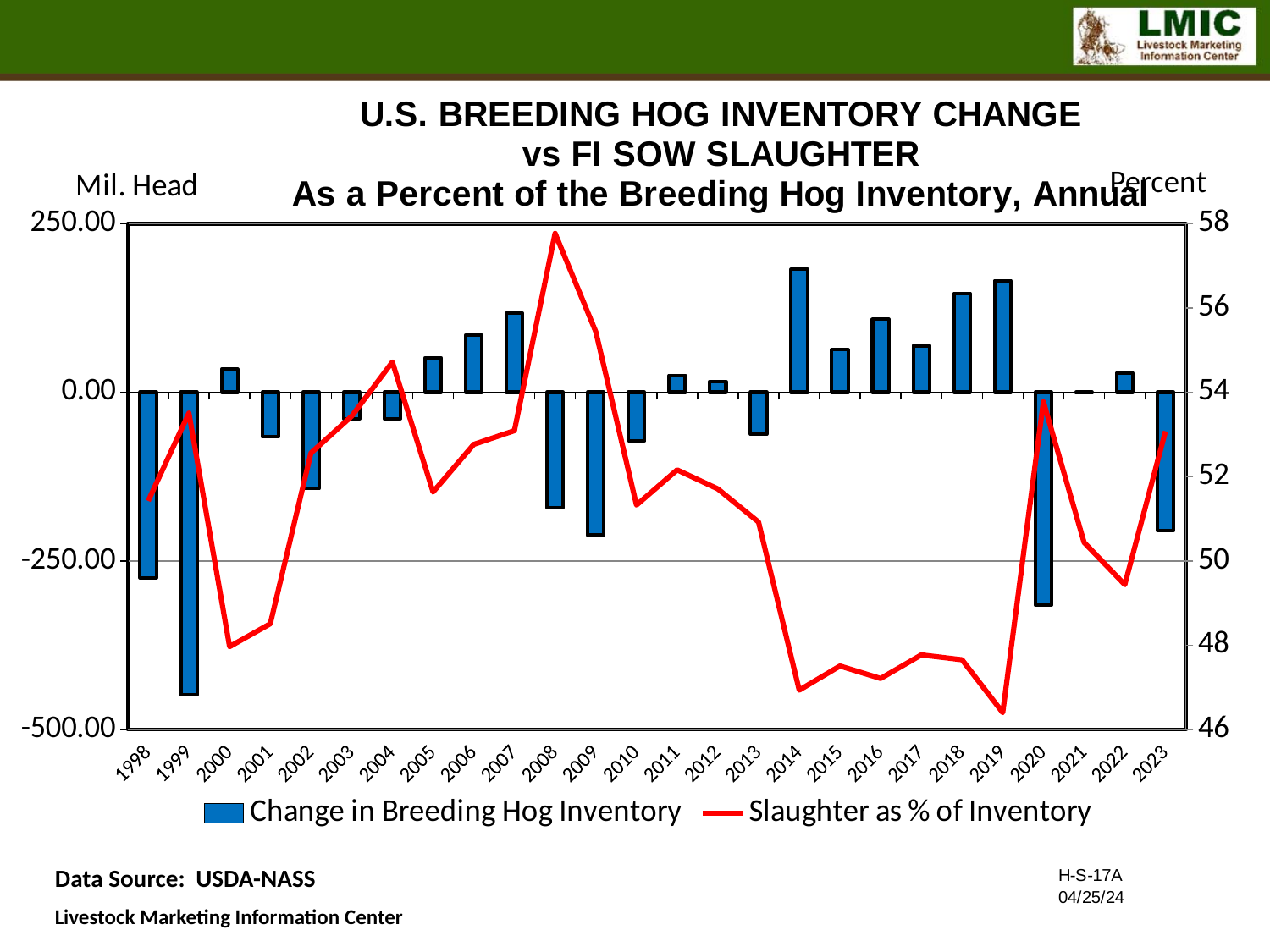
How many years are shown along the x axis? 26 What kind of chart is shown on the slide? A combination bar and line chart Which year has the lower Change in Breeding Hog Inventory bar, 1999 or 2020? 1999 Which year has the higher Slaughter as % of Inventory value, 2008 or 2014? 2008 Is the Slaughter as % of Inventory value for 2008 greater or less than 56? greater In which year does the Slaughter as % of Inventory line reach its highest point? 2008 Is the Change in Breeding Hog Inventory for 1999 greater or less than -250.00? less In which year does the Slaughter as % of Inventory line reach its lowest point? 2019 Is the Slaughter as % of Inventory value for 2019 greater or less than 48? less Which year has the lowest Change in Breeding Hog Inventory bar? 1999 What is the label on the right-hand vertical axis? Percent How many series does the legend list? 2